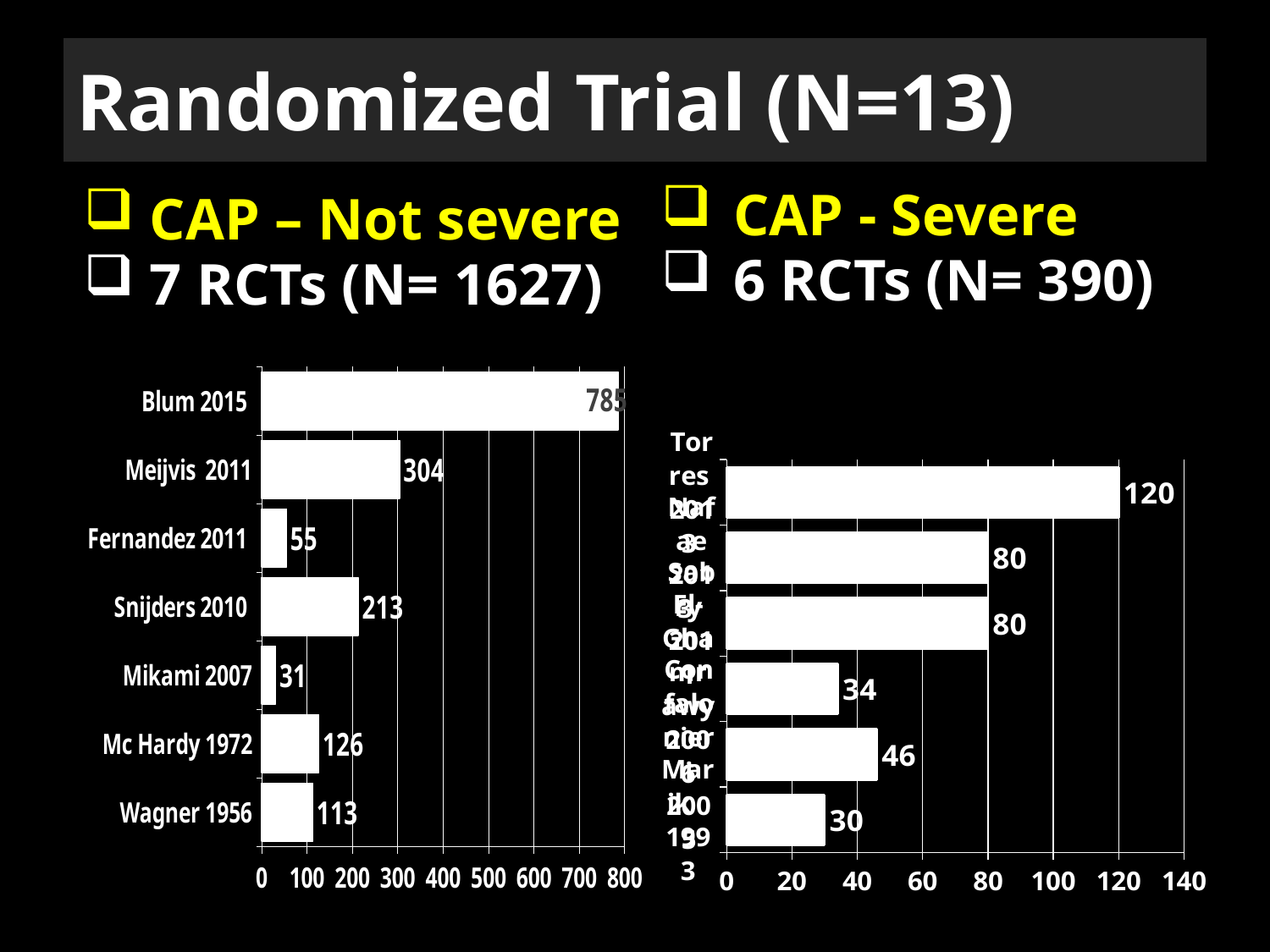
On the left chart (CAP – Not severe), what is the value for Blum 2015? 785 On the right chart (CAP - Severe), what is the value of the bottom bar? 30 On the left chart (CAP – Not severe), which study has the lowest value? Mikami 2007 On the left chart (CAP – Not severe), what is the value for Snijders 2010? 213 How many studies are plotted on the left chart (CAP – Not severe)? 7 On the left chart (CAP – Not severe), what is the difference between Meijvis 2011 and Fernandez 2011? 249 On the right chart (CAP - Severe), what is the value of the top bar? 120 How many bars are plotted on the right chart (CAP - Severe)? 6 On the left chart (CAP – Not severe), which is larger, Mc Hardy 1972 or Wagner 1956? Mc Hardy 1972 On the left chart (CAP – Not severe), what is the value for Wagner 1956? 113 What type of chart is used on the left side of the slide (CAP – Not severe)? Bar chart On the left chart (CAP – Not severe), which study has the highest value? Blum 2015